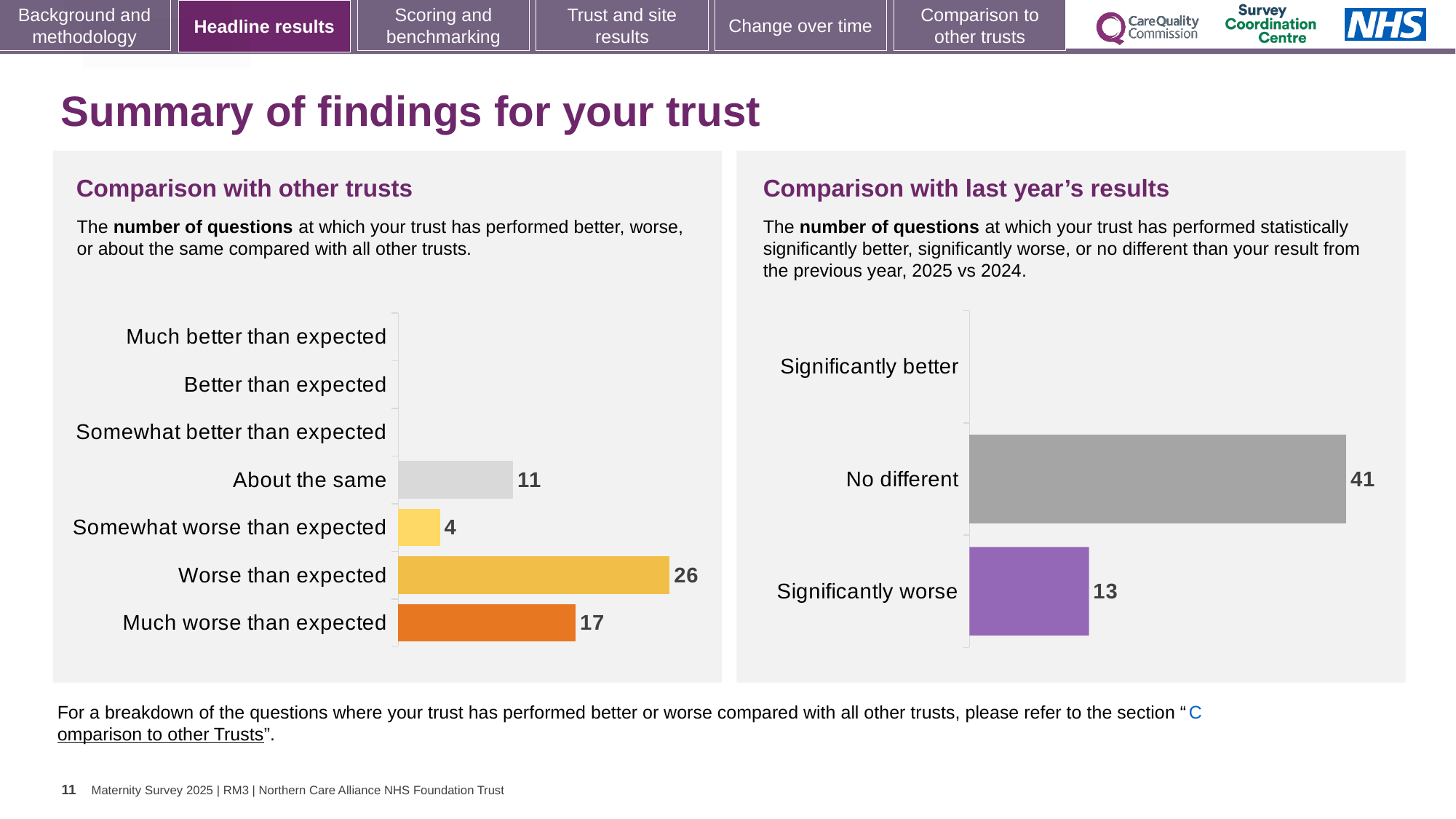
In the 'Comparison with other trusts' chart, what is the value for 'About the same'? 11 In the 'Comparison with last year's results' chart, which category has the highest value? No different In the 'Comparison with last year's results' chart, what is the difference between 'No different' and 'Significantly worse'? 28 In the 'Comparison with last year's results' chart, what is the value for 'Significantly worse'? 13 What type of chart is the 'Comparison with last year's results' chart? Bar chart In the 'Comparison with last year's results' chart, what is the value for 'No different'? 41 In the 'Comparison with other trusts' chart, what is the value for 'Much worse than expected'? 17 In the 'Comparison with other trusts' chart, how many categories are listed on the axis? 7 In the 'Comparison with other trusts' chart, which is larger: 'About the same' or 'Somewhat worse than expected'? About the same In the 'Comparison with other trusts' chart, how many questions are rated 'Worse than expected'? 26 In the 'Comparison with other trusts' chart, which category has the highest value? Worse than expected In the 'Comparison with other trusts' chart, what is the difference between 'Worse than expected' and 'Much worse than expected'? 9